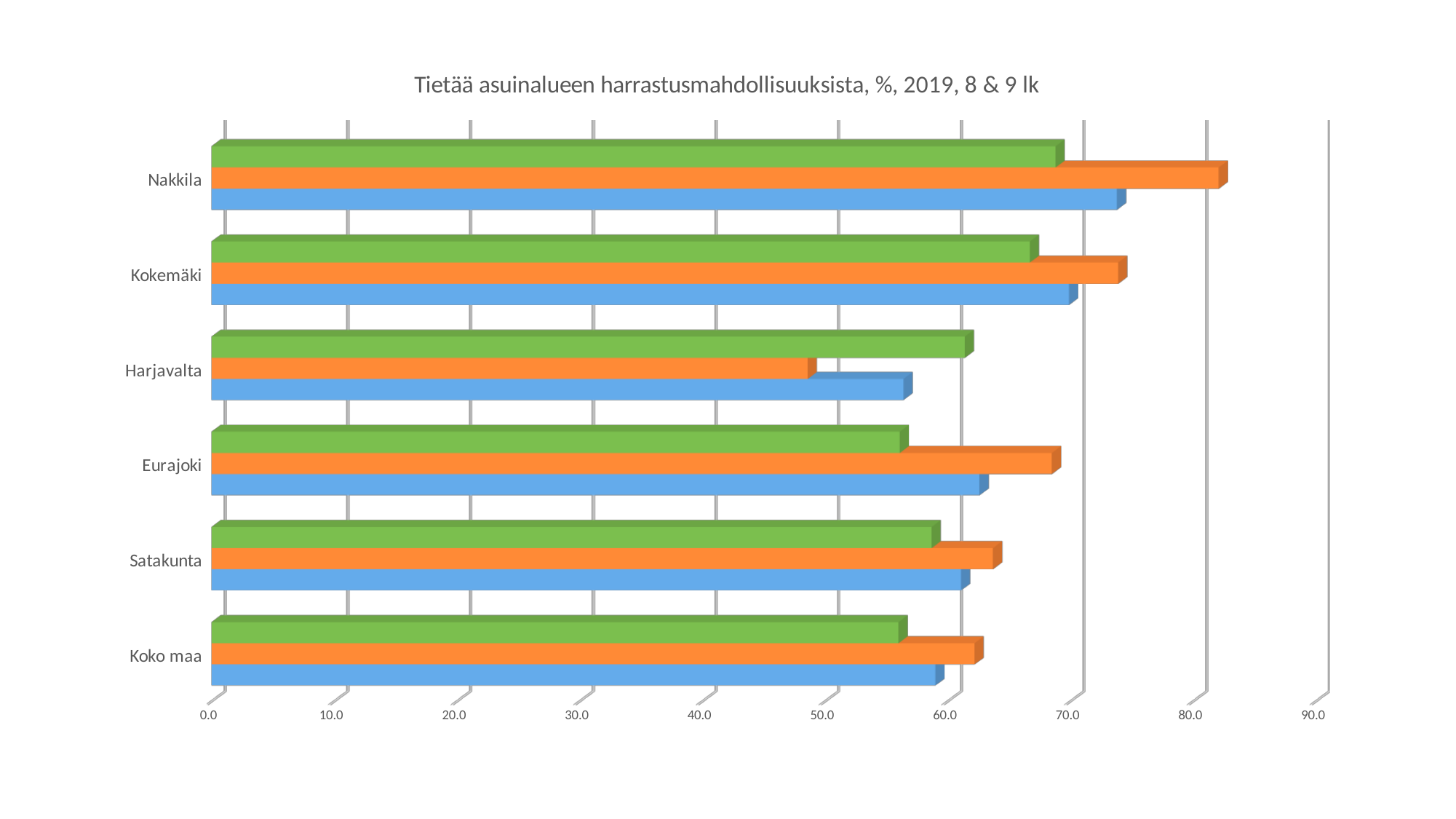
For Nakkila, which is larger: the orange bar or the blue bar? orange bar Which category has the longest orange bar? Nakkila Which category has the shortest orange bar? Harjavalta What kind of chart is shown on the slide? bar chart Which category has the longest blue bar? Nakkila How many categories are shown on the vertical axis of the chart? 6 Is the value of the green bar for Eurajoki greater or less than 60? less Is the value of the orange bar for Nakkila greater or less than 80? greater For Harjavalta, which is larger: the green bar or the orange bar? green bar How many bars are plotted for each category in the chart? 3 What is the title of the chart? Tietää asuinalueen harrastusmahdollisuuksista, %, 2019, 8 & 9 lk Is the value of the orange bar for Harjavalta greater or less than 60? less